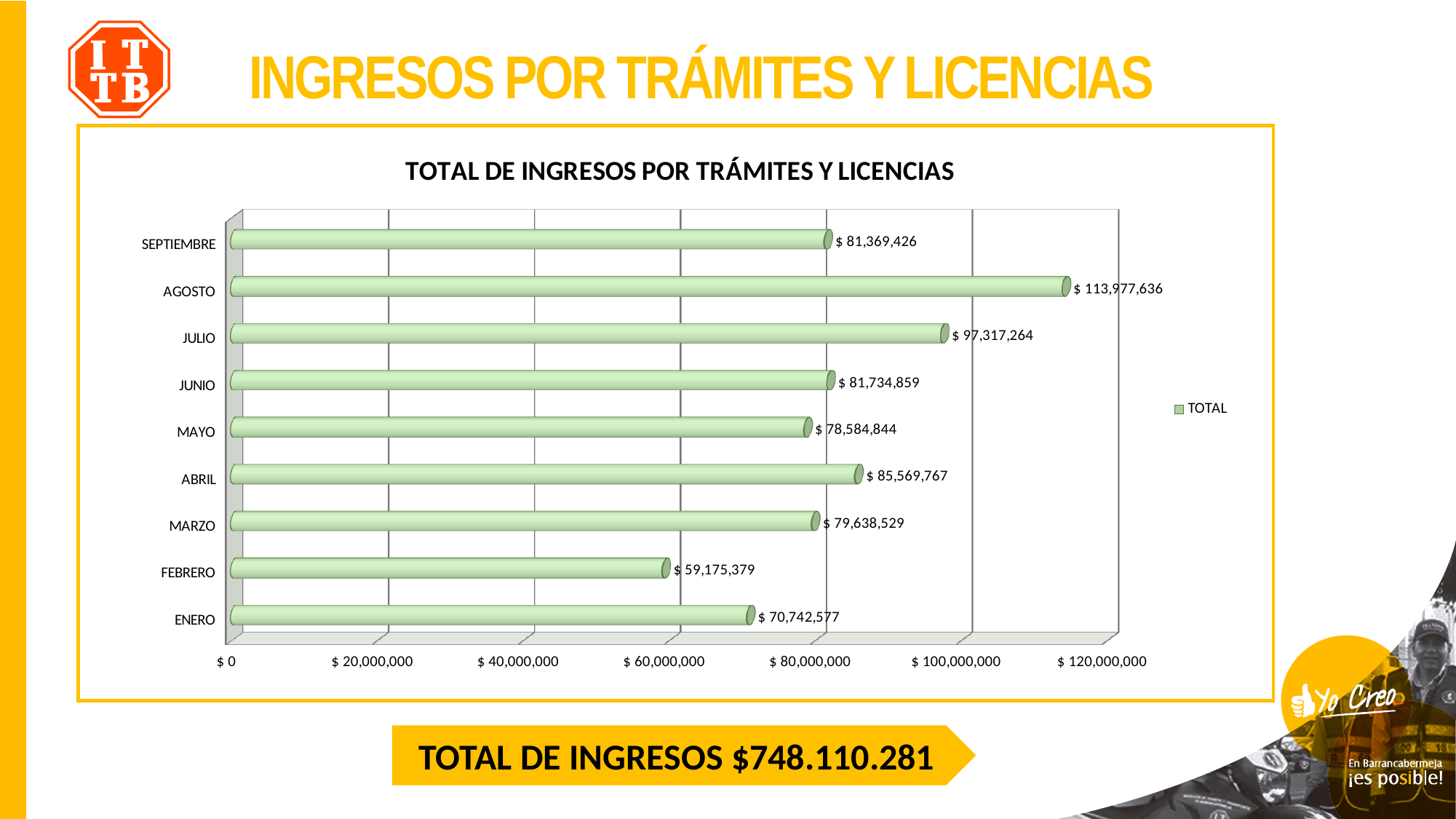
What is the difference between the values for JULIO and ENERO? $ 26,574,687 What is the value for AGOSTO? $ 113,977,636 What is the value for JULIO? $ 97,317,264 Which month has the highest value? AGOSTO What is the difference between the values for AGOSTO and FEBRERO? $ 54,802,257 What is the value for FEBRERO? $ 59,175,379 What kind of chart is shown? bar chart How many series does the legend list? 1 How many months are shown in the chart? 9 Which is larger, the value for ABRIL or the value for MAYO? ABRIL Which month has the lowest value? FEBRERO Is the value for ENERO greater or less than $ 60,000,000? greater